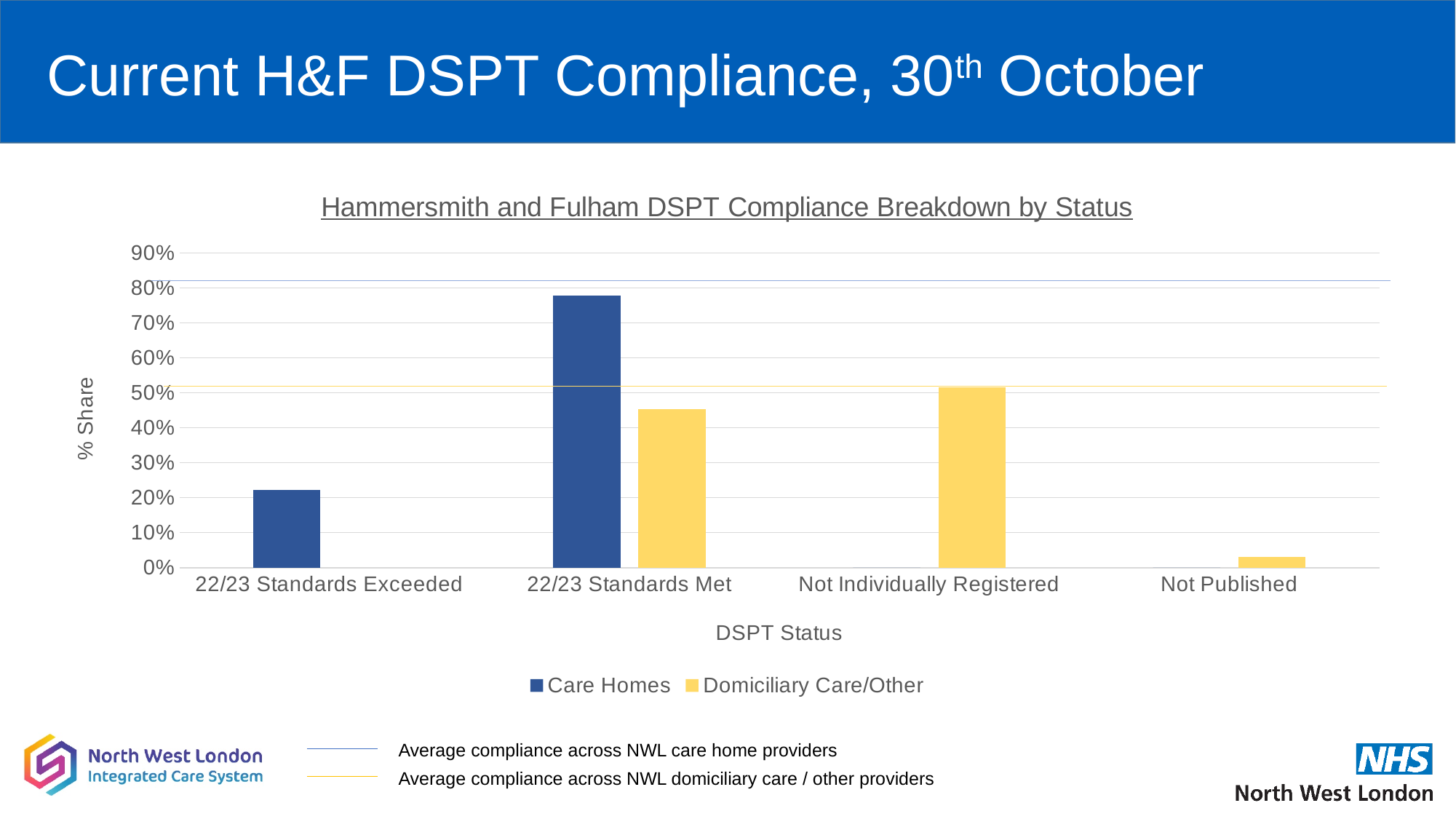
Which DSPT status has the highest value for Domiciliary Care/Other? Not Individually Registered Is the Care Homes value for 22/23 Standards Met greater or less than 70%? greater How many DSPT status categories are shown on the x axis? 4 Which DSPT status has the highest value for Care Homes? 22/23 Standards Met What is the label on the y axis of the chart? % Share What kind of chart is shown on the slide? Bar chart For 22/23 Standards Met, which series has the larger value, Care Homes or Domiciliary Care/Other? Care Homes Is the Domiciliary Care/Other value for Not Published greater or less than 10%? less How many series does the chart legend list? 2 Is the Care Homes value for 22/23 Standards Exceeded greater or less than 30%? less What is the title of the chart? Hammersmith and Fulham DSPT Compliance Breakdown by Status